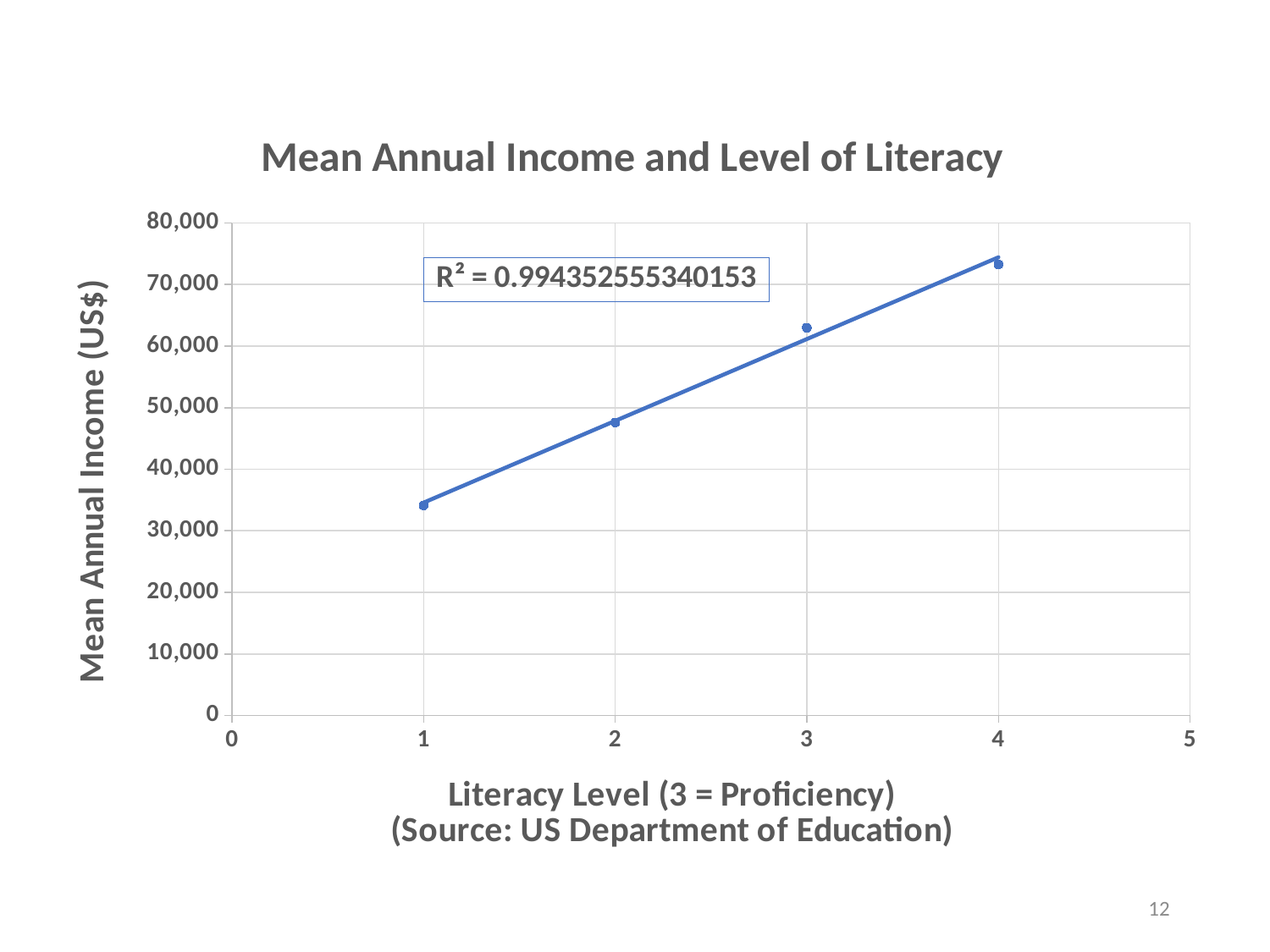
Which literacy level has the lowest mean annual income? 1 Which has a higher mean annual income, literacy level 2 or literacy level 3? literacy level 3 Which literacy level has the highest mean annual income? 4 Is the mean annual income for literacy level 3 greater or less than 60,000? greater How many data points are plotted on the chart? 4 Does mean annual income rise or fall as literacy level increases? rise Is the mean annual income for literacy level 4 greater or less than 70,000? greater Is the mean annual income for literacy level 2 greater or less than 50,000? less What R² value is shown on the chart? 0.994352555340153 What kind of chart is shown on the slide? scatter chart What is the title of the chart? Mean Annual Income and Level of Literacy